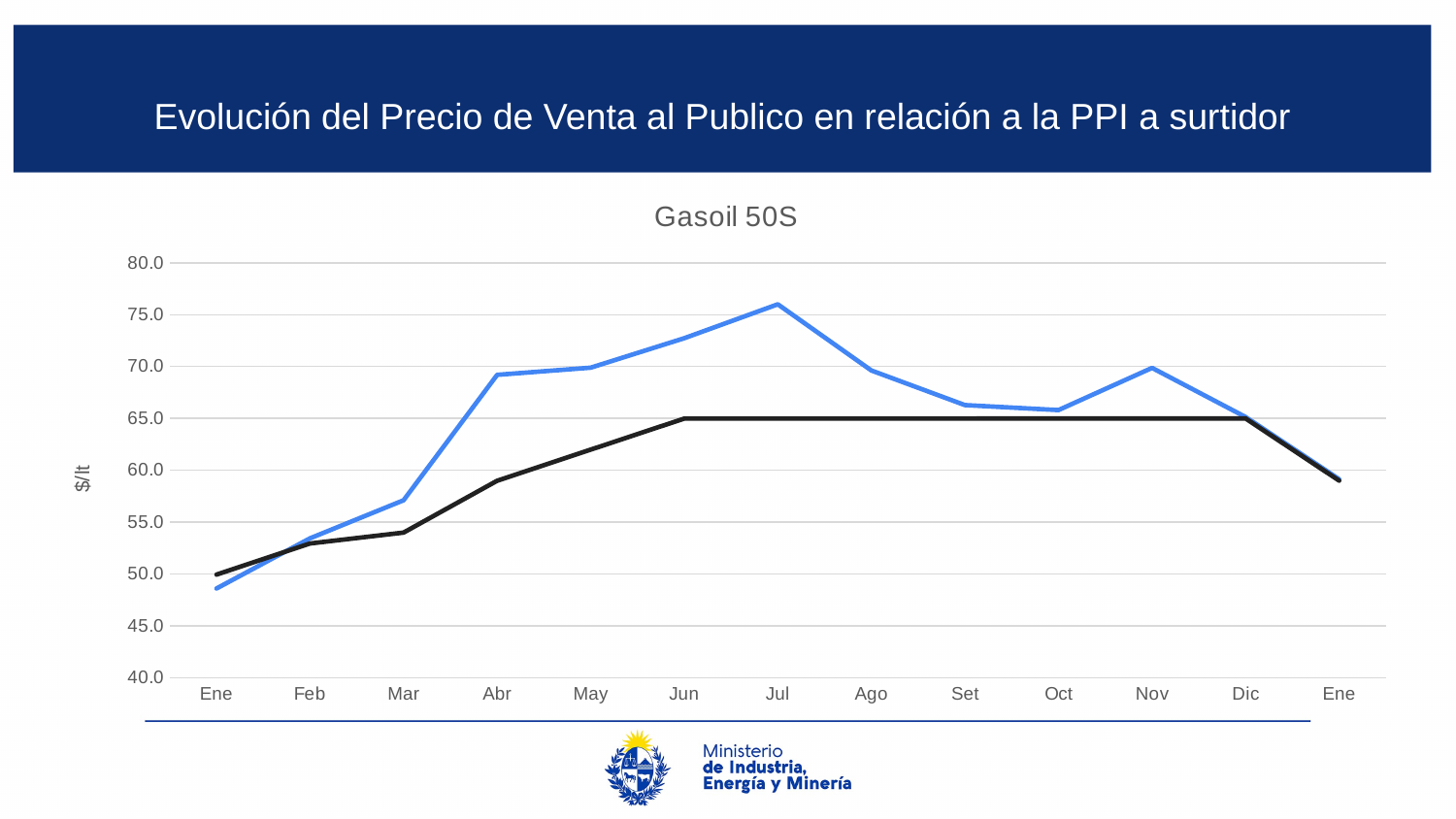
In the first Ene, which line has the higher value, the blue line or the black line? black line What kind of chart is shown on the slide? line chart What is the label on the y axis of the chart? $/lt Does the blue line rise or fall from Jul to Set? fall Is the value of the blue line in Mar greater or less than 60.0? less In Abr, which line has the higher value, the blue line or the black line? blue line How many points are plotted along the x axis of the Gasoil 50S chart? 13 In which month does the blue line reach its highest value? Jul Is the value of the blue line in Jul greater or less than 70.0? greater What is the title of the chart? Gasoil 50S In which month does the blue line reach its lowest value? Ene (first) Does the black line rise or fall from Ene to Jun? rise